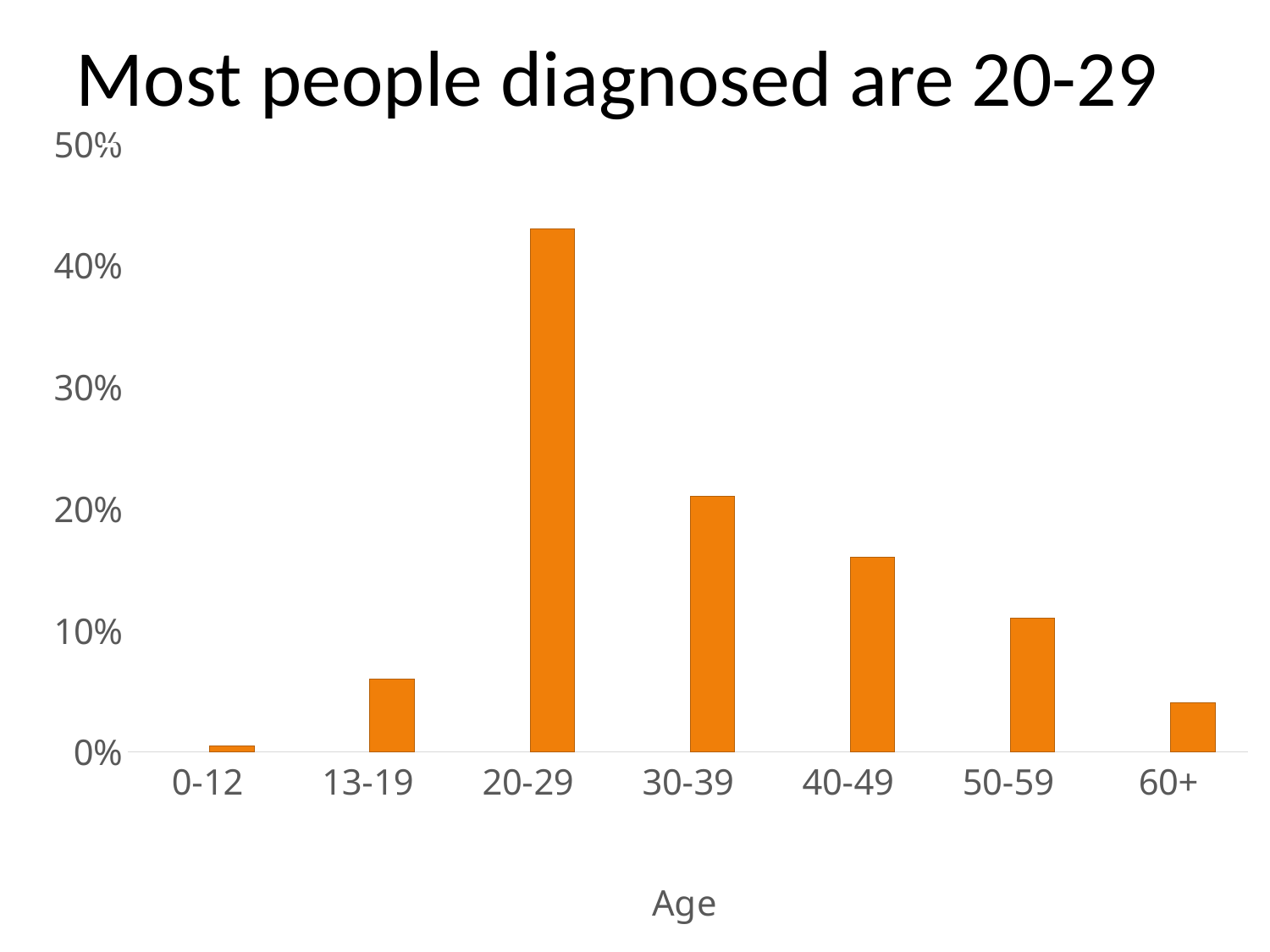
Which is larger, the value for 30-39 or the value for 40-49? 30-39 What is the label of the x axis? Age Is the value for 60+ greater or less than 10%? less Is the value for 20-29 greater or less than 40%? greater Is the value for 13-19 greater or less than 10%? less Which age group has the lowest value? 0-12 Which age group has the highest value? 20-29 How many age groups are shown on the x axis? 7 What kind of chart is shown on the slide? bar chart What is the title of the chart? Most people diagnosed are 20-29